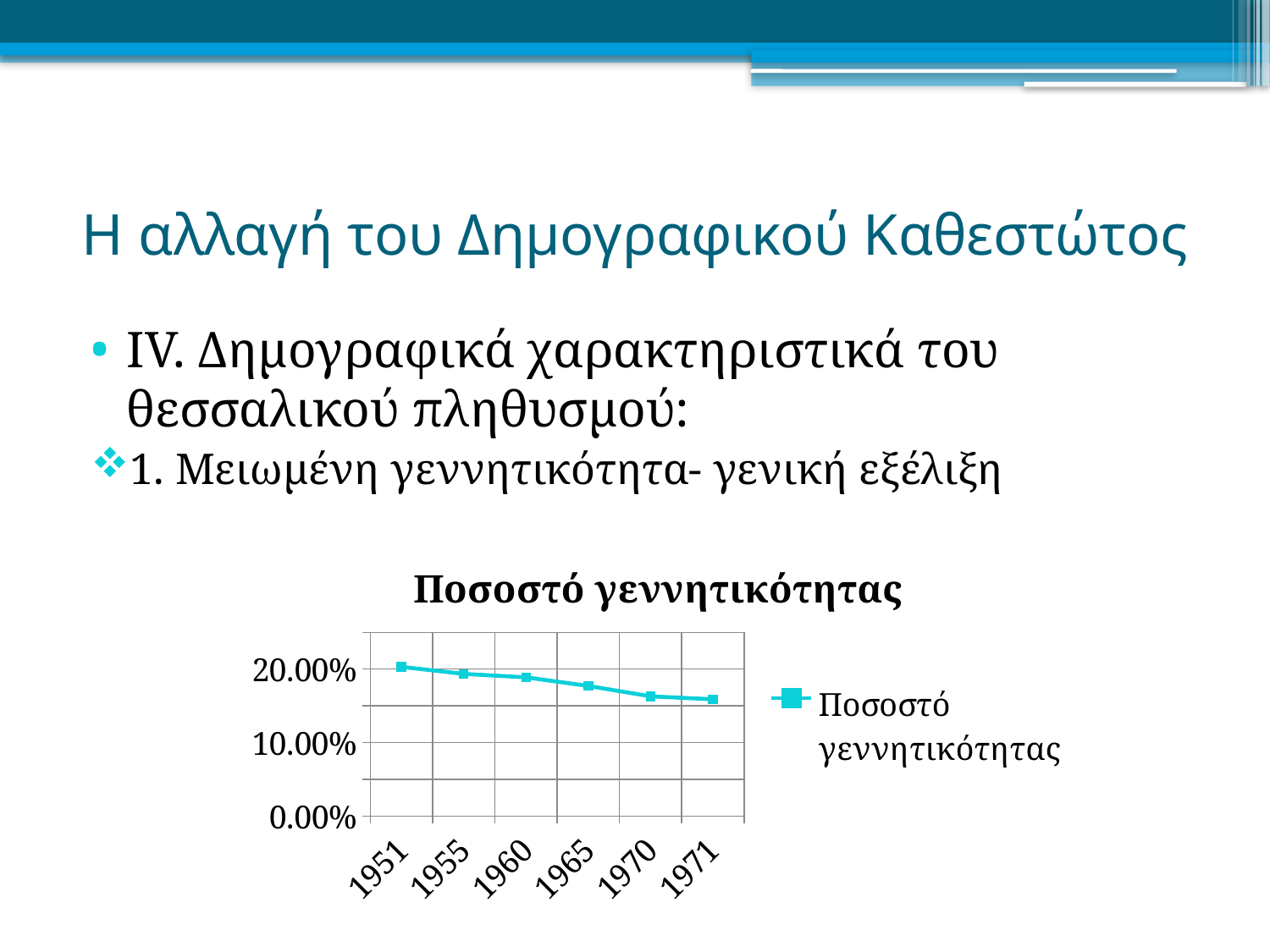
Is the value for 1951 greater or less than 10.00%? greater Which year has the highest value in the chart? 1951 Which is larger, the value for 1951 or the value for 1970? 1951 How many years are plotted along the x axis of the chart? 6 Do the values in the chart rise or fall from 1951 to 1971? fall Is the value for 1970 greater or less than 20.00%? less What is the title of the chart? Ποσοστό γεννητικότητας What is the name of the series shown in the chart legend? Ποσοστό γεννητικότητας How many series does the chart legend list? 1 What kind of chart is shown on the slide? line chart Is the value for 1971 greater or less than 10.00%? greater Which is larger, the value for 1955 or the value for 1971? 1955